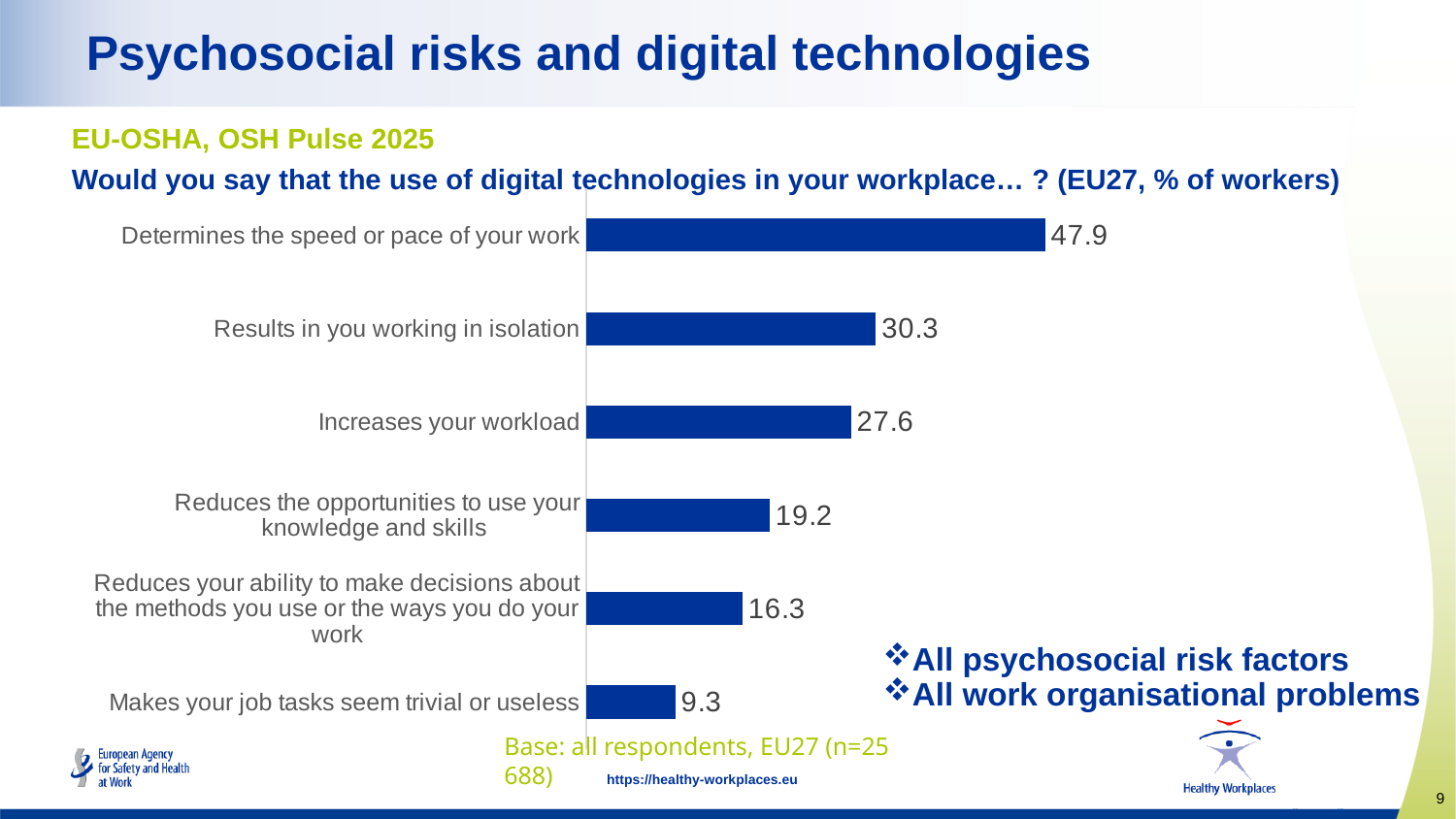
What is the base (number of respondents) stated for the chart? All respondents, EU27 (n=25 688) Which is larger: 'Results in you working in isolation' or 'Increases your workload'? Results in you working in isolation How many categories are shown in the chart? 6 Which category has the lowest value? Makes your job tasks seem trivial or useless Which category has the highest value? Determines the speed or pace of your work What is the difference between 'Determines the speed or pace of your work' and 'Results in you working in isolation'? 17.6 What is the difference between 'Reduces the opportunities to use your knowledge and skills' and 'Reduces your ability to make decisions about the methods you use or the ways you do your work'? 2.9 What is the value for 'Results in you working in isolation'? 30.3 What type of chart is shown on the slide? Bar chart What is the value for 'Makes your job tasks seem trivial or useless'? 9.3 What percentage of workers say the use of digital technologies determines the speed or pace of their work? 47.9 What is the value for 'Increases your workload'? 27.6